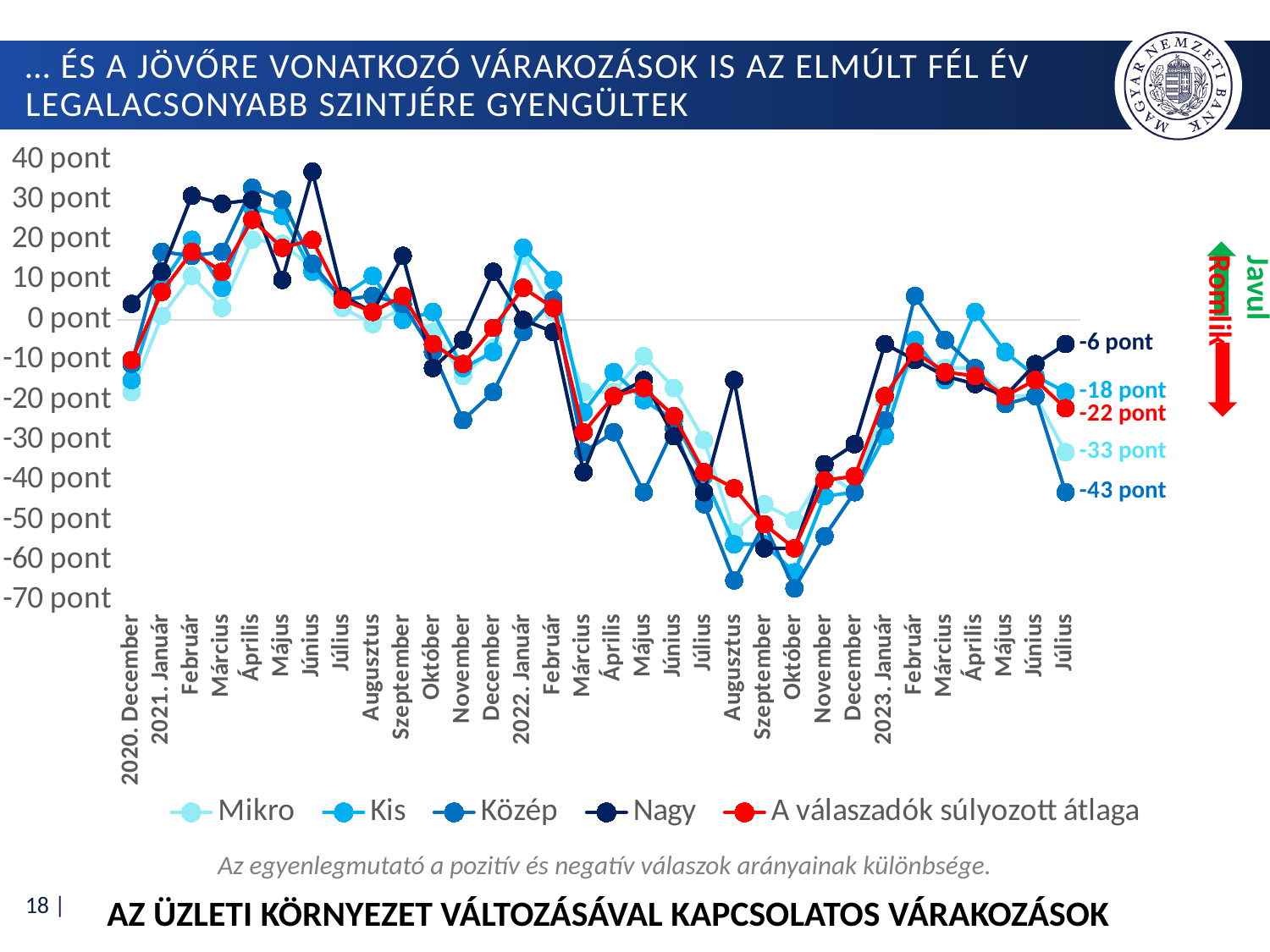
What is the value for Mikro at the last point (2023. Július)? -33 pont What is the value for Nagy at the last point (2023. Július)? -6 pont What is the difference between the Nagy and Közép values at the last point (2023. Július)? 37 pont What is the value for Közép at the last point (2023. Július)? -43 pont How many series does the legend list? 5 Which series has the lowest value at the last point (2023. Július)? Közép What is the value for A válaszadók súlyozott átlaga at the last point (2023. Július)? -22 pont Which series has the highest value at the last point (2023. Július)? Nagy What kind of chart is shown on the slide? line chart Is the value for Nagy in 2021. Június greater or less than 30 pont? greater Is the value for Közép in 2022. Október greater or less than -60 pont? less At the last point (2023. Július), which is larger: the value for Kis or the value for Mikro? Kis